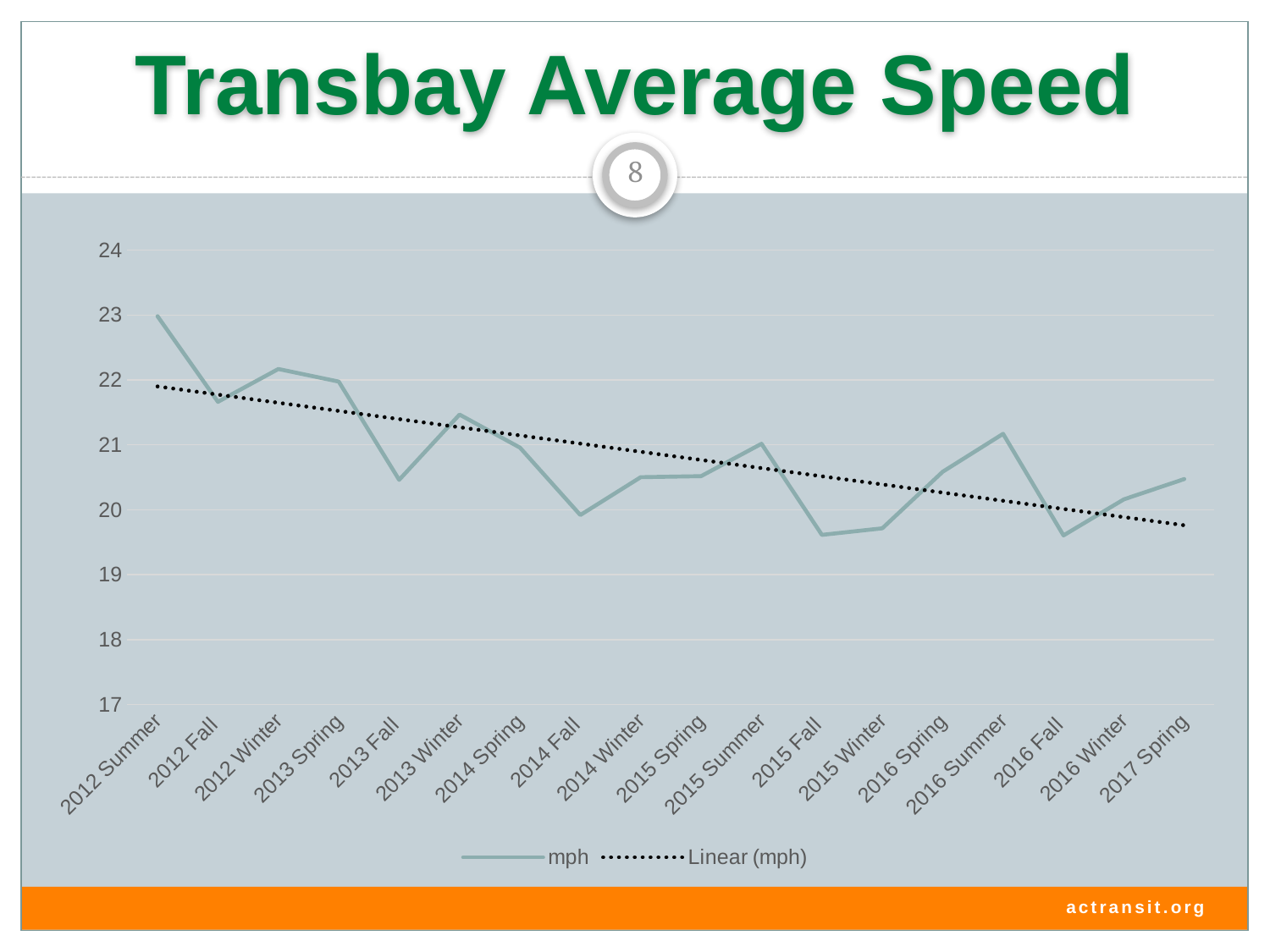
How many series does the chart legend list? 2 Is the mph value for 2015 Fall greater or less than 20? less Is the mph value for 2013 Winter greater or less than 21? greater Is the mph value for 2013 Fall greater or less than 21? less How many periods are plotted along the x axis? 18 Which period has the highest mph value? 2012 Summer What is the title of the chart on the slide? Transbay Average Speed What kind of chart is shown on the slide? Line chart What are the two entries in the chart legend? mph and Linear (mph) Does the mph line generally rise or fall from 2012 Summer to 2017 Spring? Fall Which has the larger mph value, 2013 Fall or 2013 Winter? 2013 Winter